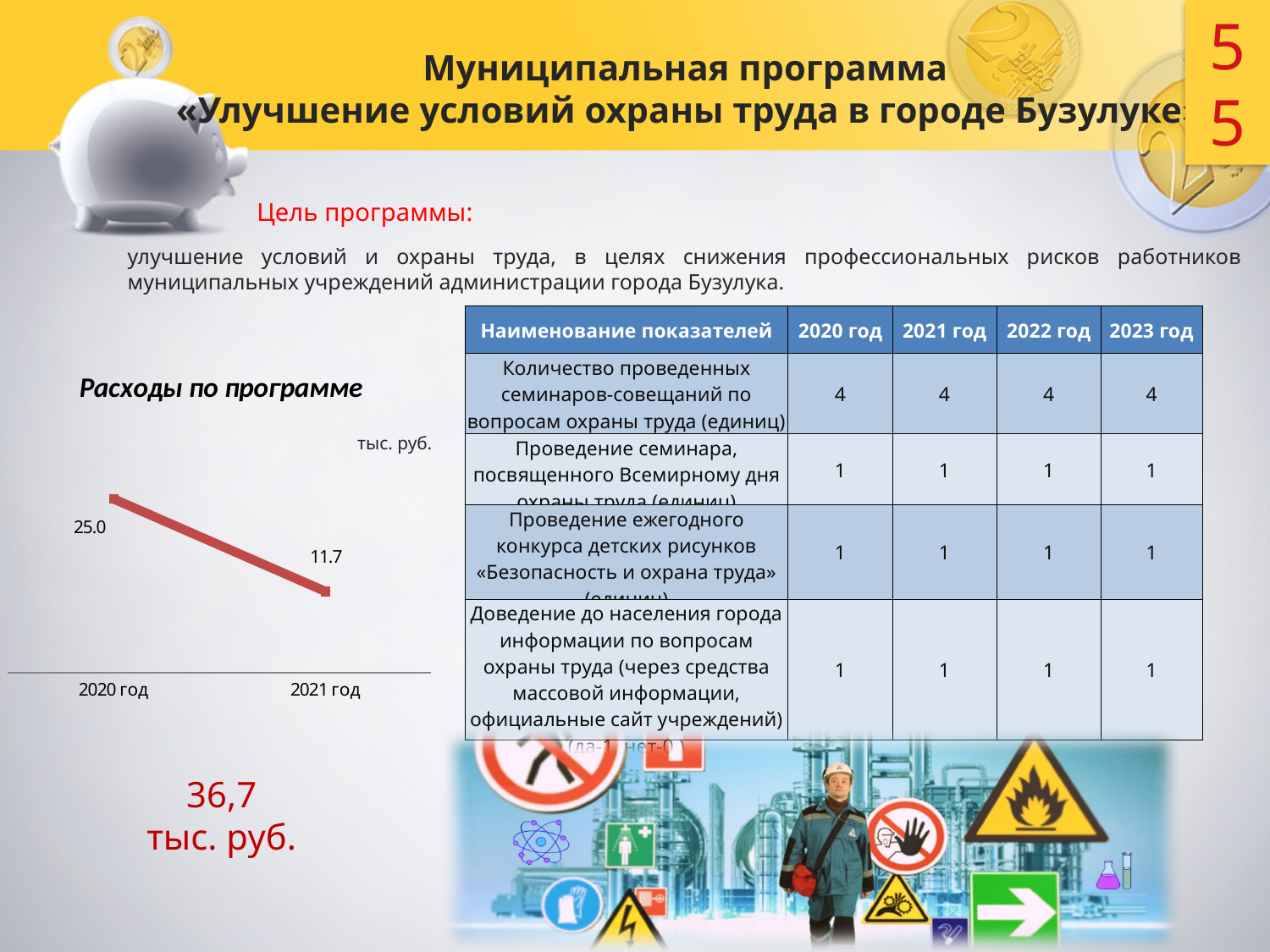
Do the values in the 'Расходы по программе' chart rise or fall from 2020 год to 2021 год? fall What is the value for 2021 год in the 'Расходы по программе' chart? 11.7 In the 'Расходы по программе' chart, which is larger: the value for 2020 год or for 2021 год? 2020 год What is the title of the line chart on the slide? Расходы по программе What kind of chart is 'Расходы по программе'? line chart How many data points are plotted in the 'Расходы по программе' chart? 2 In the 'Расходы по программе' chart, what is the difference between the values for 2020 год and 2021 год? 13.3 Which year has the highest value in the 'Расходы по программе' chart? 2020 год What unit is shown for the values in the 'Расходы по программе' chart? тыс. руб. What is the value for 2020 год in the 'Расходы по программе' chart? 25.0 Which year has the lowest value in the 'Расходы по программе' chart? 2021 год